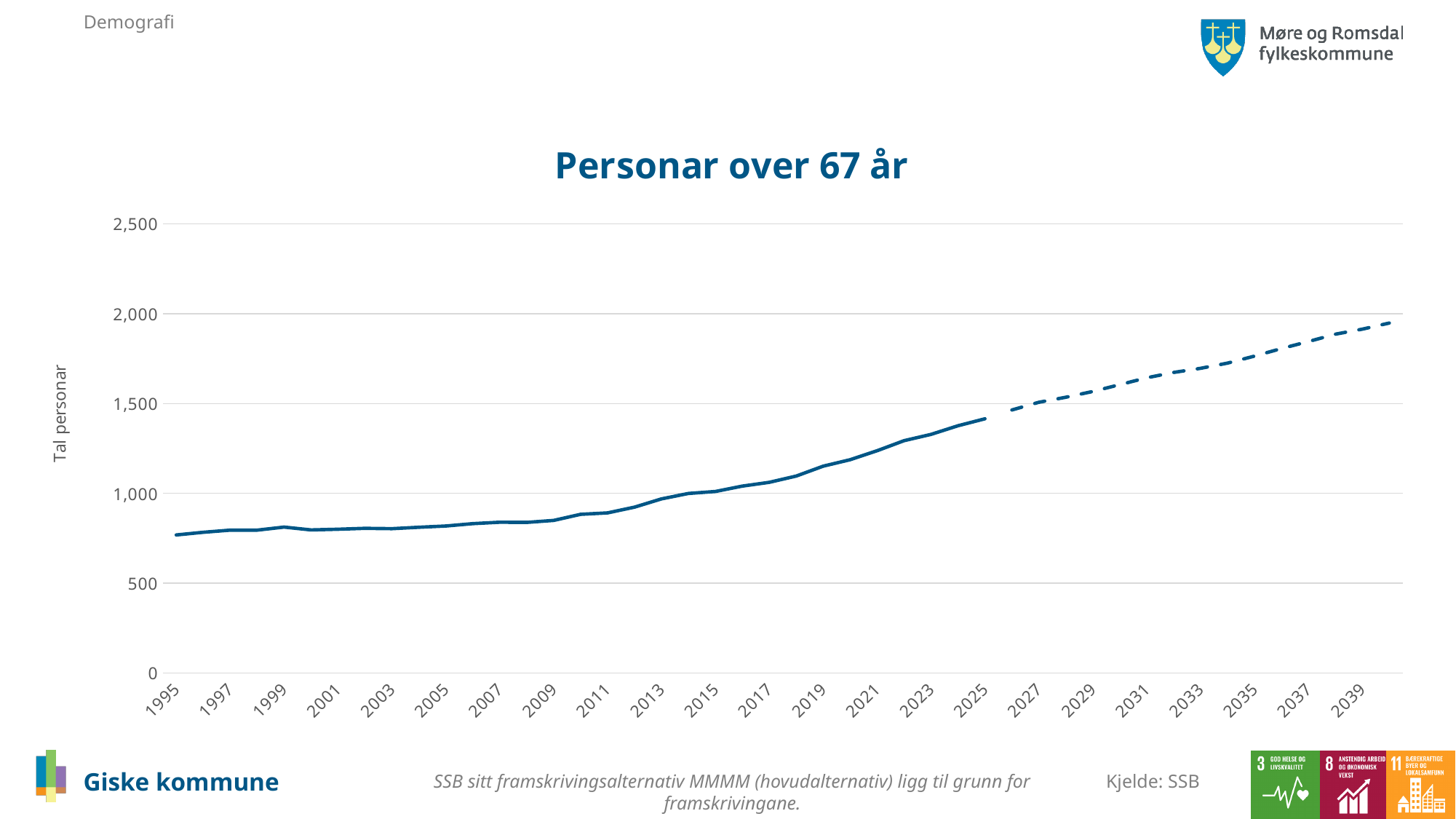
Is the value for 2025 greater or less than 1,500? less Is the value for 1995 greater or less than 1,000? less Is the value for 2005 greater or less than 1,000? less Which year has a larger value, 2015 or 2023? 2023 Do the values rise or fall along the x axis from 1995 to 2039? rise What kind of chart is shown on the slide? line chart What is the title of the chart? Personar over 67 år What is the label on the vertical axis of the chart? Tal personar How many year labels are shown on the x axis? 23